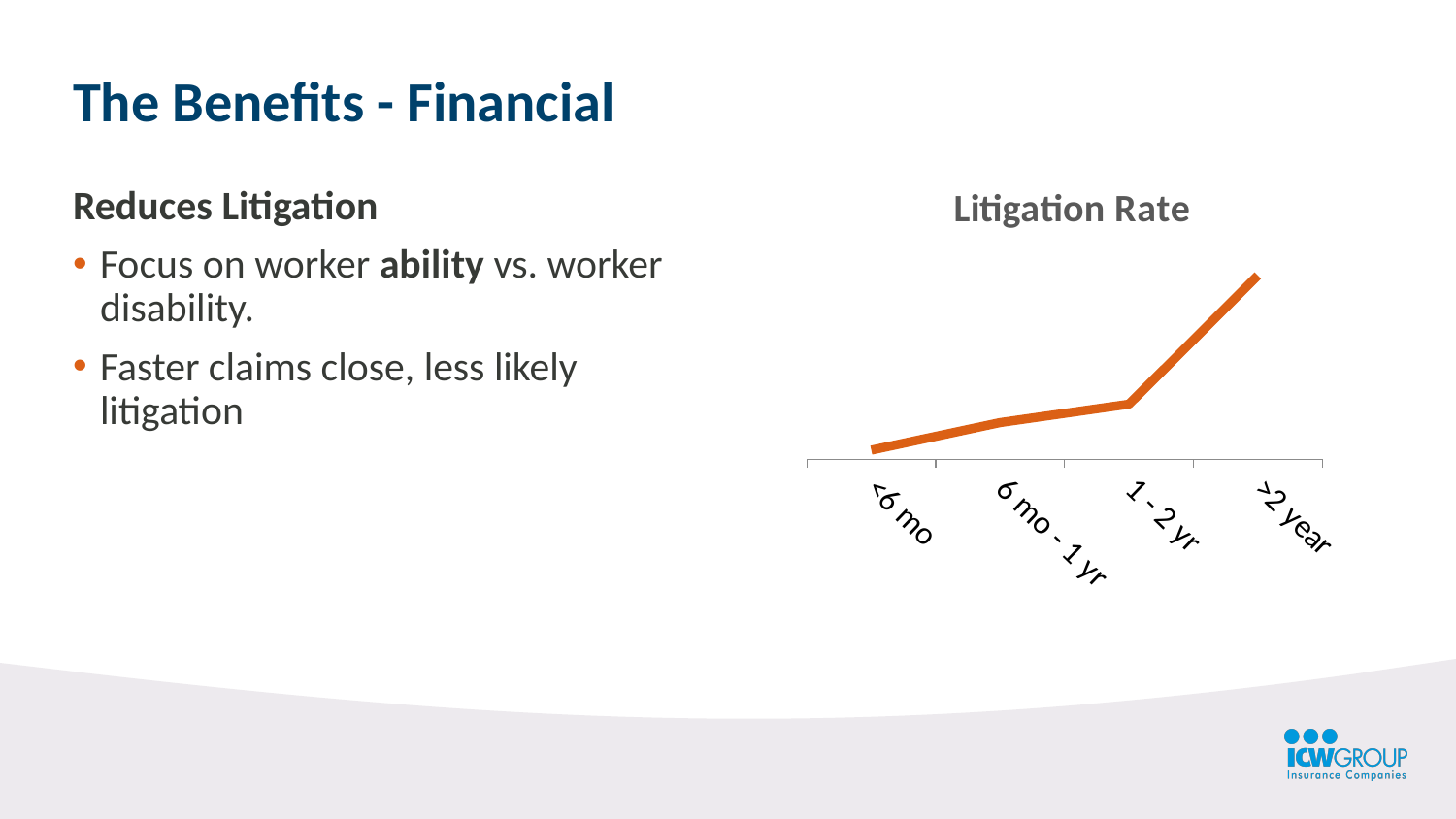
Which category has the highest litigation rate in the chart? >2 year Between which two consecutive categories does the litigation rate increase the most? 1 - 2 yr and >2 year Does the litigation rate rise or fall as you move from <6 mo to >2 year along the x axis? Rise Which has a higher litigation rate, 1 - 2 yr or >2 year? >2 year What kind of chart is shown on the slide? Line chart What is the title of the chart? Litigation Rate What is the label of the first category on the x axis of the Litigation Rate chart? <6 mo Which category has the lowest litigation rate in the chart? <6 mo Which has a lower litigation rate, <6 mo or 6 mo - 1 yr? <6 mo How many categories are plotted along the x axis of the Litigation Rate chart? 4